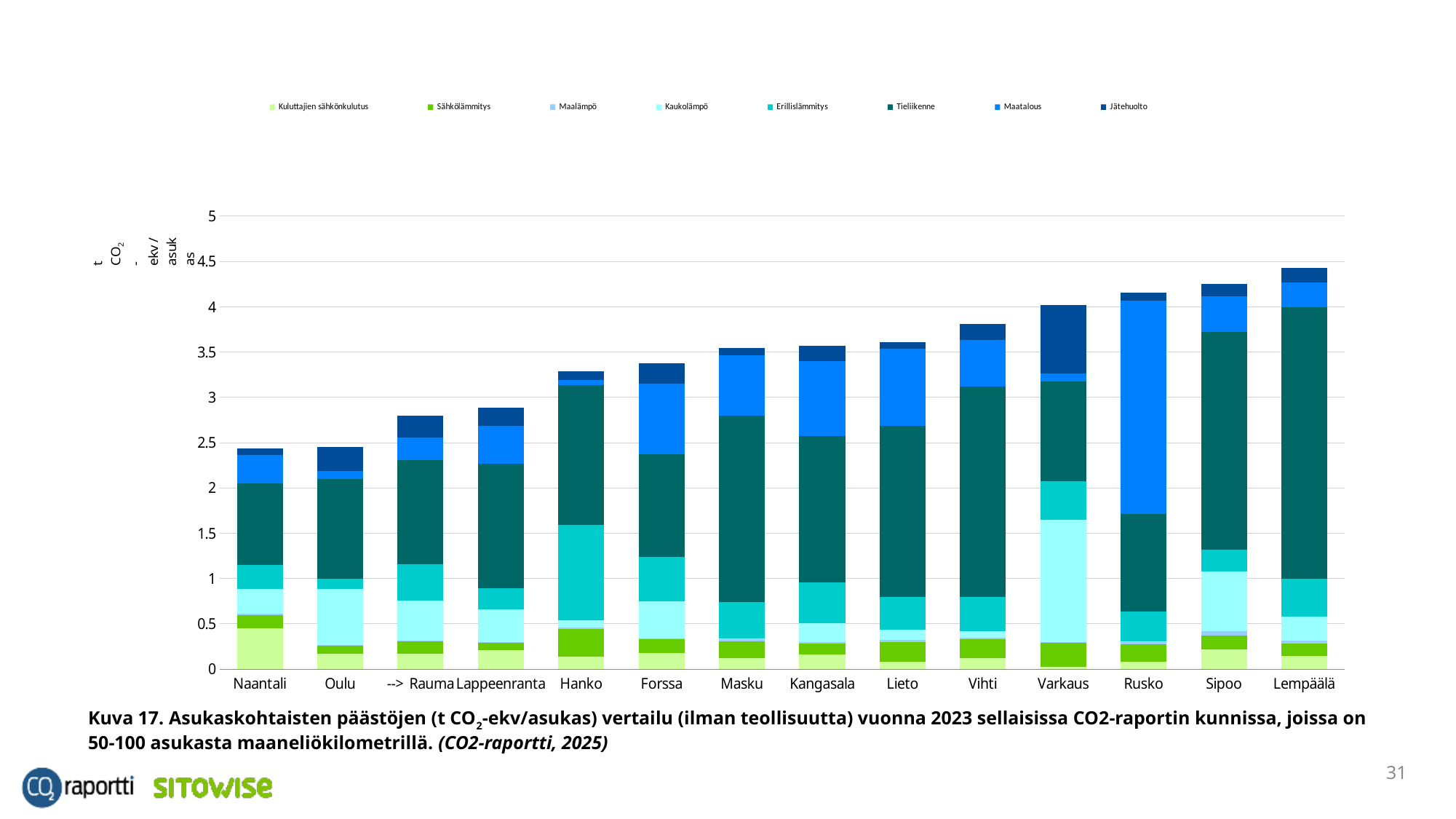
Do the total bar heights generally rise or fall from left to right along the x axis? rise What is the first series listed in the chart's legend? Kuluttajien sähkönkulutus Is the total value for Hanko greater or less than 3? greater How many series does the chart's legend list? 8 Which municipality has the largest Maatalous (agriculture) segment? Rusko Which municipality has the highest total per-capita emissions in the chart? Lempäälä Is the total value for Rusko greater or less than 4? greater How many municipalities are shown on the x axis of the chart? 14 Which has the larger total bar, Sipoo or Forssa? Sipoo Is the total value for Lempäälä greater or less than 4? greater What kind of chart is shown on the slide? Stacked bar chart